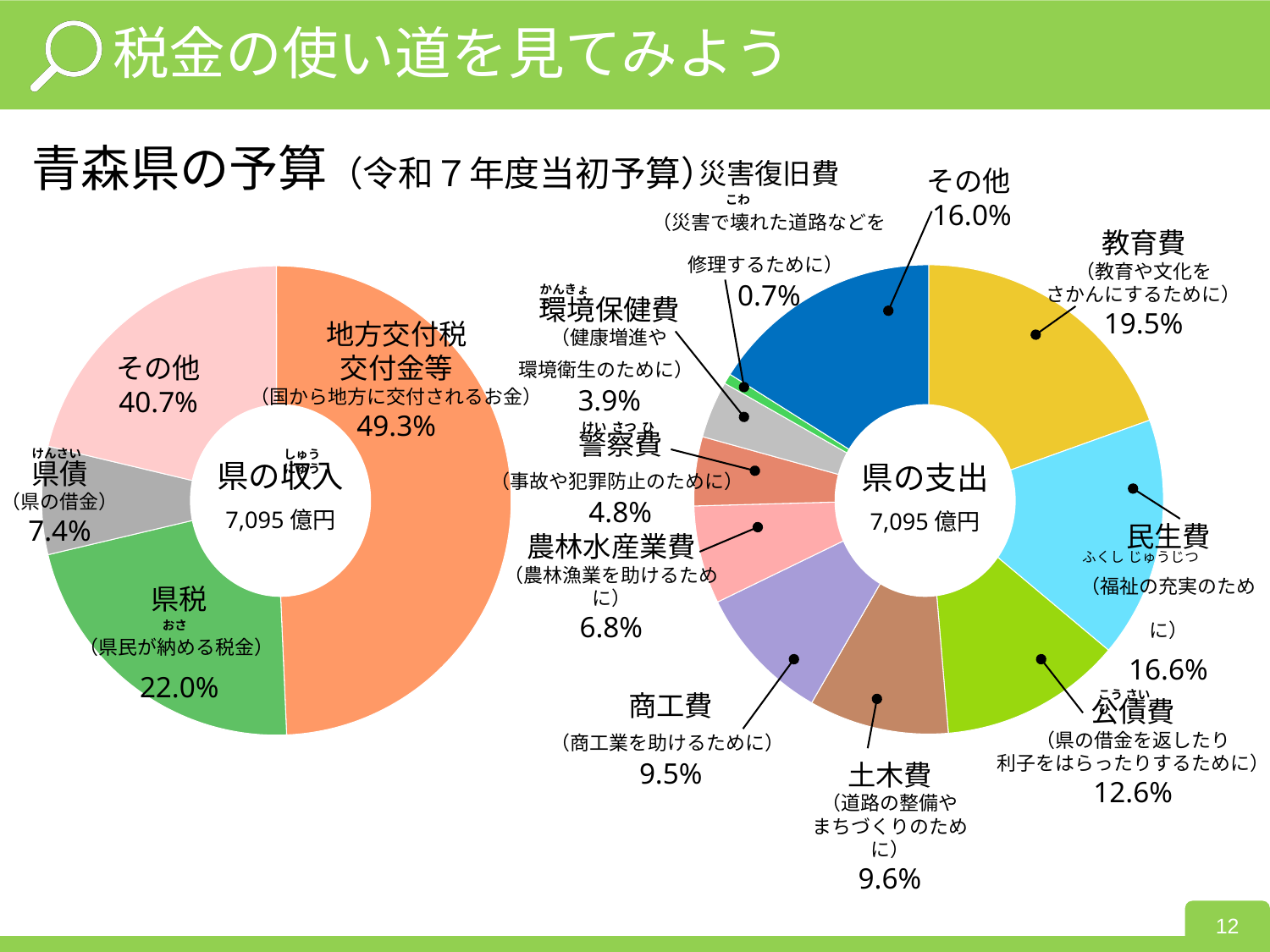
In the 県の収入 chart, what percentage is 地方交付税交付金等? 49.3% In the 県の支出 chart, which category has the largest share? 教育費 What type of chart is used for 県の収入 on the left of the slide? pie chart (donut) In the 県の収入 chart, which category has the smallest share? 県債 In the 県の支出 chart, what percentage is 災害復旧費? 0.7% In the 県の支出 chart, what percentage is 教育費? 19.5% In the 県の支出 chart, what is the difference between 民生費 and 公債費? 4.0% In the 県の収入 chart, which category has the largest share? 地方交付税交付金等 In the 県の収入 chart, what percentage is 県税? 22.0% In the 県の支出 chart, which is larger, 警察費 or 農林水産業費? 農林水産業費 What total amount is shown in the center of the 県の支出 chart? 7,095 億円 How many categories are shown in the 県の収入 chart? 4